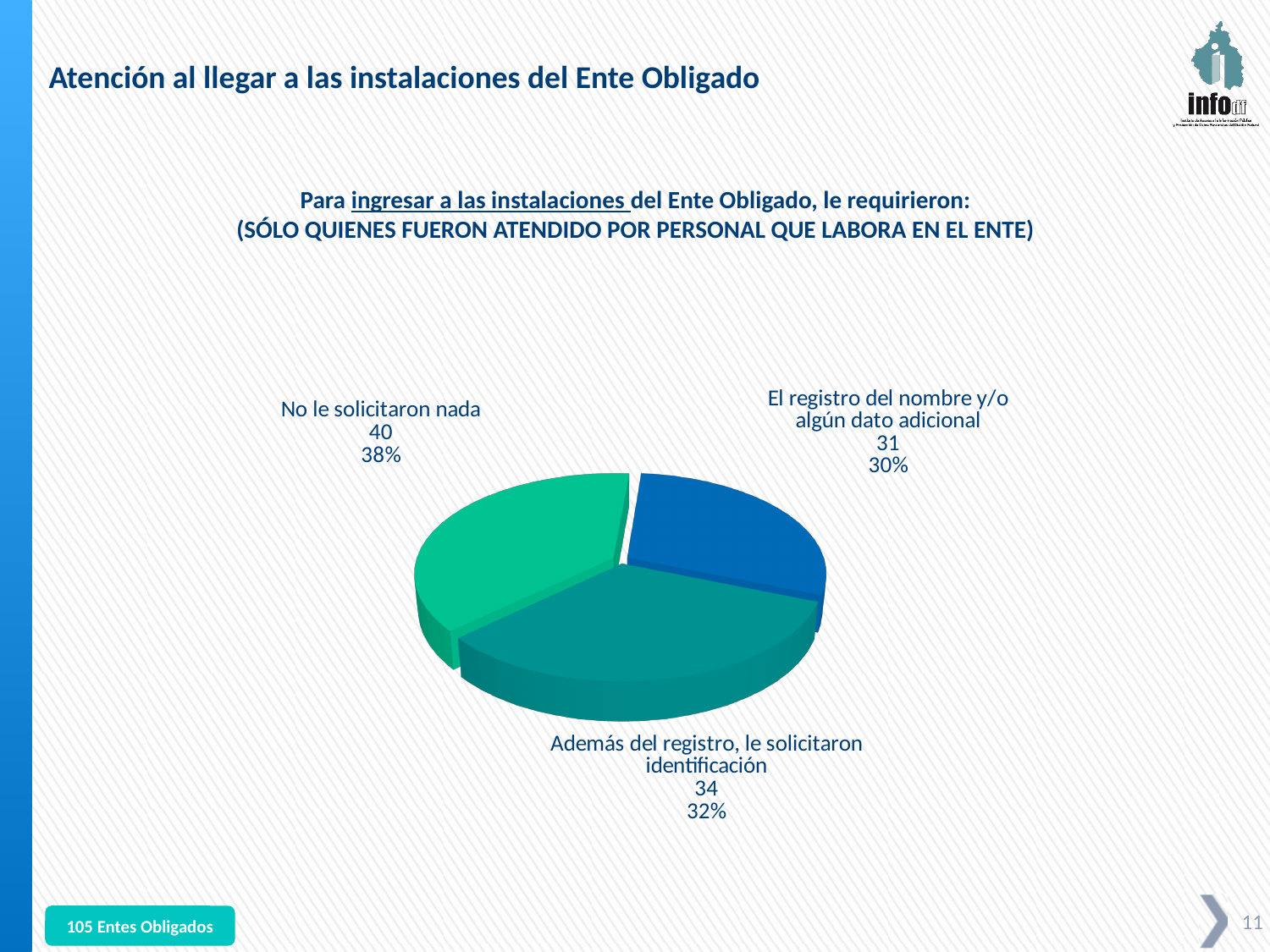
Which is larger: "Además del registro, le solicitaron identificación" or "El registro del nombre y/o algún dato adicional"? Además del registro, le solicitaron identificación What is the value for "No le solicitaron nada"? 40 What share of the pie does "No le solicitaron nada" represent? 38% What percentage is shown for "El registro del nombre y/o algún dato adicional"? 30% What colour is the slice for "El registro del nombre y/o algún dato adicional"? Blue How many slices does the pie chart have? 3 What is the total of the three slice values? 105 Which category has the largest slice? No le solicitaron nada Which category has the smallest slice? El registro del nombre y/o algún dato adicional What is the difference between the values for "No le solicitaron nada" and "El registro del nombre y/o algún dato adicional"? 9 What is the value for "Además del registro, le solicitaron identificación"? 34 What type of chart is shown on the slide? Pie chart